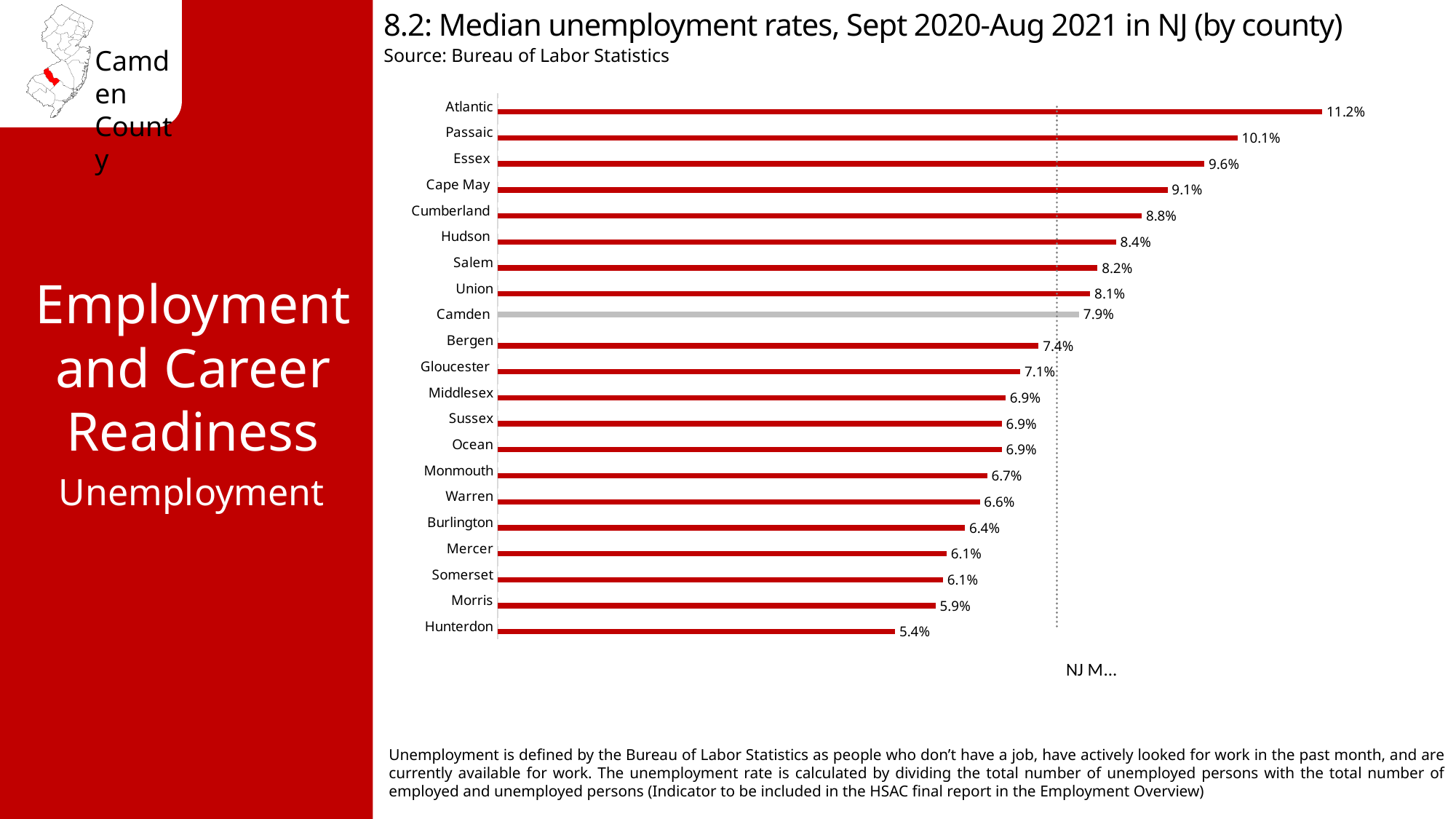
What is the median unemployment rate for Hunterdon county? 5.4% What is the difference between the median unemployment rates of Camden and Burlington counties? 1.5% How many counties are shown in the chart? 21 Which county has the highest median unemployment rate? Atlantic What is the median unemployment rate for Camden county? 7.9% What is the median unemployment rate for Atlantic county? 11.2% Which county has a higher median unemployment rate, Passaic or Essex? Passaic Which county has the lowest median unemployment rate? Hunterdon What is the median unemployment rate for Gloucester county? 7.1% What type of chart is shown on the slide? Bar chart Which county's bar is shown in a different colour (grey) from the others? Camden What is the difference between the median unemployment rates of Atlantic and Hunterdon counties? 5.8%